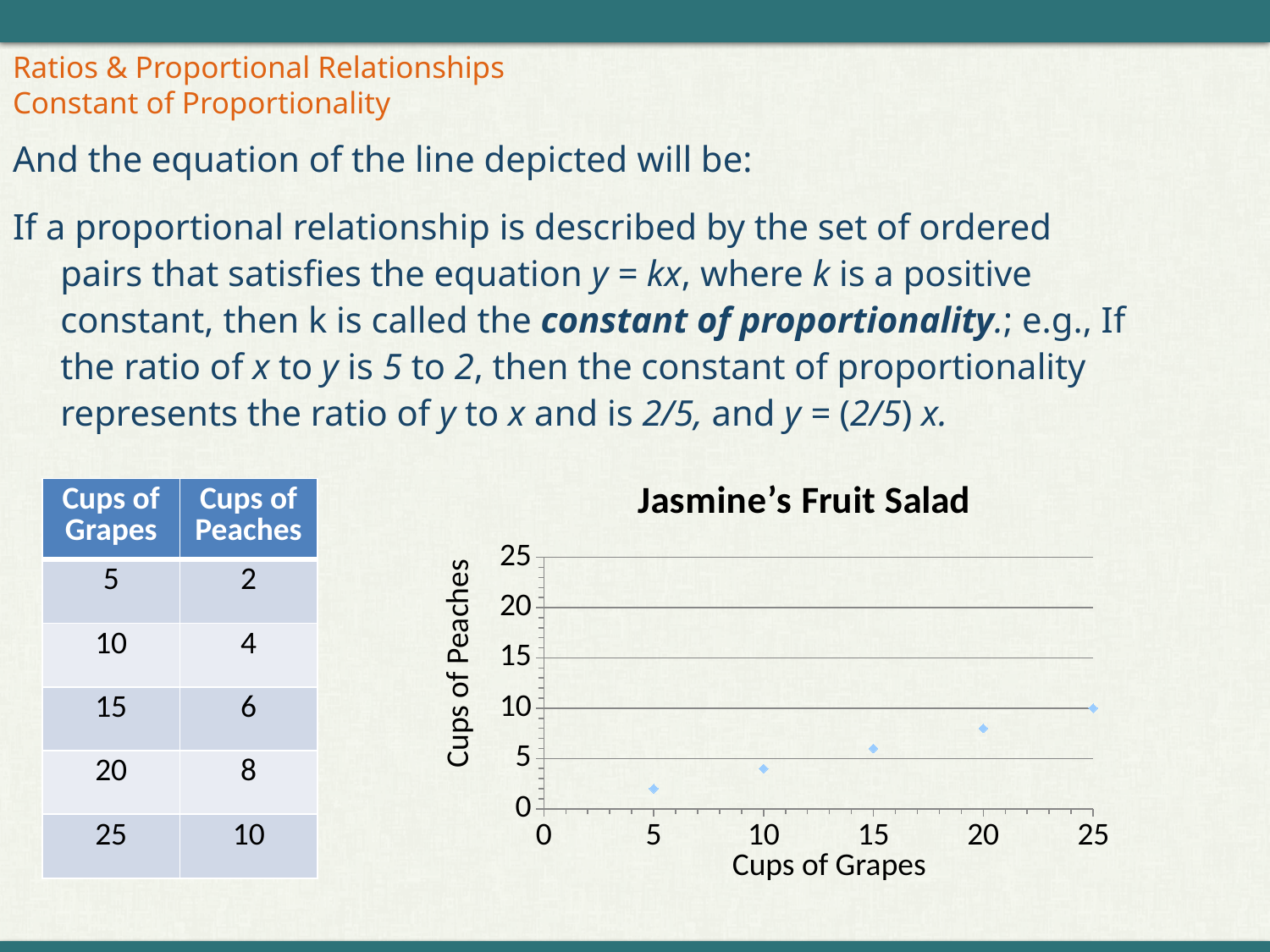
Is the value of cups of peaches for 20 cups of grapes greater or less than 5? greater Which number of cups of grapes has the highest number of cups of peaches? 25 Is the value of cups of peaches for 10 cups of grapes greater or less than 5? less What kind of chart is shown on the slide? scatter chart How many cups of peaches correspond to 5 cups of grapes? 2 How many cups of peaches correspond to 15 cups of grapes? 6 Which number of cups of grapes has the lowest number of cups of peaches? 5 How many cups of peaches correspond to 25 cups of grapes on the chart? 10 How many data points are plotted on the chart? 5 Do the cups of peaches rise or fall as the cups of grapes increase along the x axis? rise What is the title of the chart? Jasmine's Fruit Salad What is the label of the x axis of the chart? Cups of Grapes